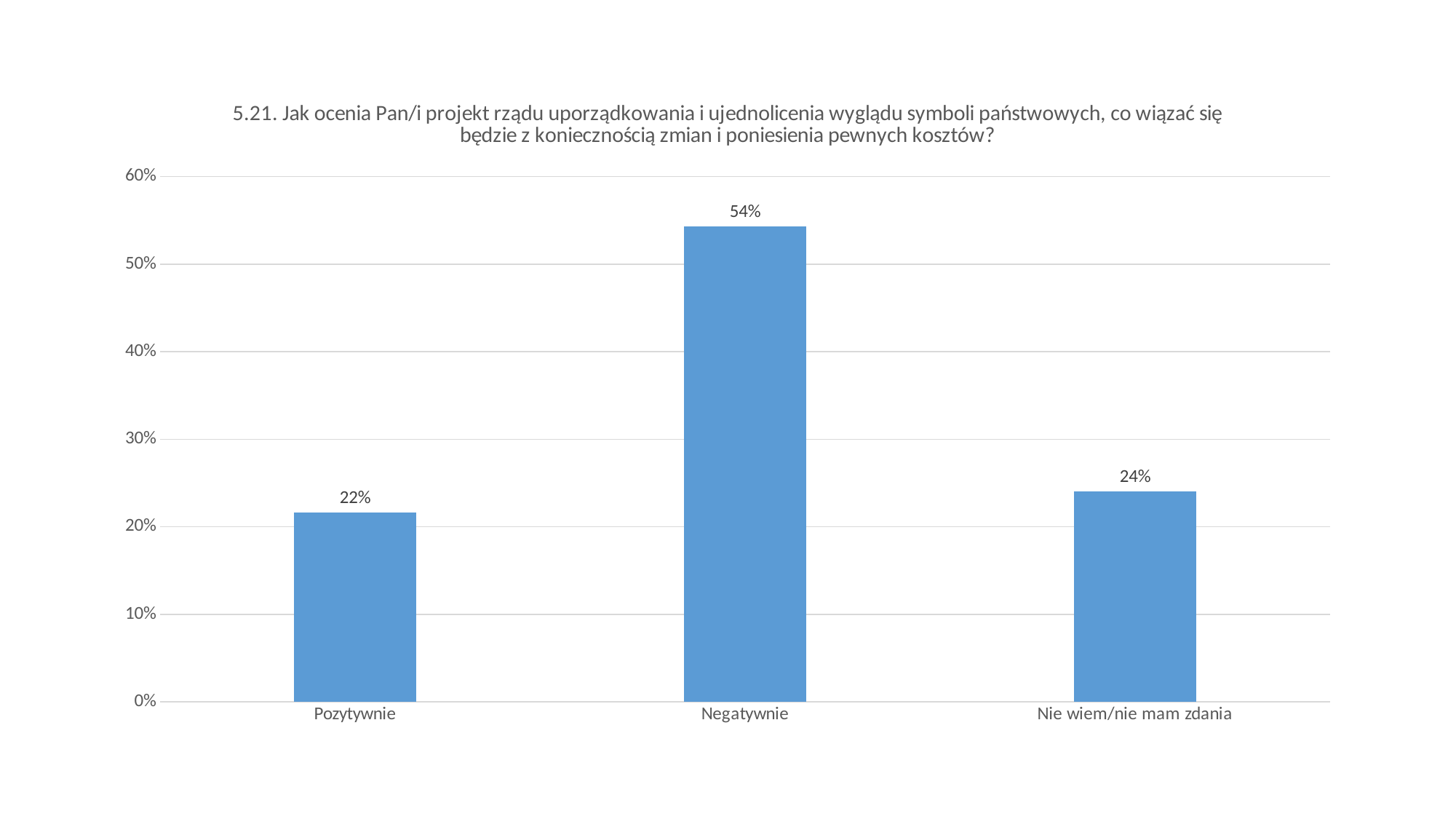
How many categories are shown on the x axis? 3 What is the difference between the values for Negatywnie and Pozytywnie? 32% Which category has the highest value? Negatywnie What is the value for Negatywnie? 54% What is the value for Nie wiem/nie mam zdania? 24% Is the value for Negatywnie greater or less than 50%? greater What kind of chart is shown on the slide? bar chart Which is larger, the value for Negatywnie or the value for Nie wiem/nie mam zdania? Negatywnie Which category has the lowest value? Pozytywnie What is the difference between the values for Nie wiem/nie mam zdania and Pozytywnie? 2% What is the value for Pozytywnie? 22% What is the highest value shown on the vertical axis? 60%